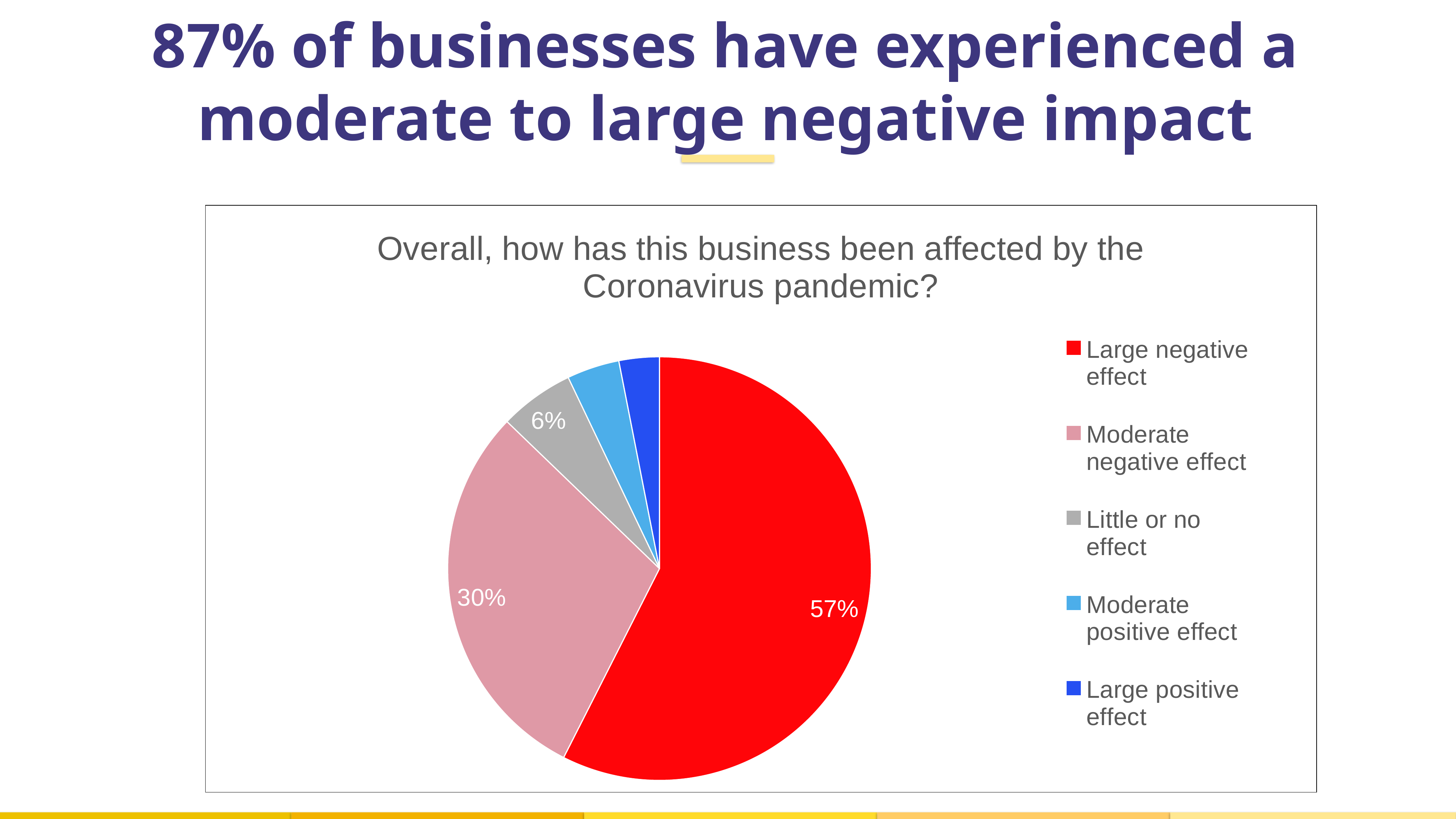
What combined percentage of businesses reported either a large or moderate negative effect? 87% What percentage of businesses reported little or no effect? 6% How many response categories does the pie chart show? 5 What percentage of businesses reported a moderate negative effect? 30% What percentage of businesses reported a large negative effect? 57% How many entries does the legend list? 5 What kind of chart is shown on the slide? Pie chart What colour is the slice for large negative effect? Red What is the difference in percentage points between the large negative effect and moderate negative effect slices? 27 Which response category has the largest share of the pie? Large negative effect What is the title of the chart? Overall, how has this business been affected by the Coronavirus pandemic? Which is larger: the moderate negative effect slice or the little or no effect slice? Moderate negative effect